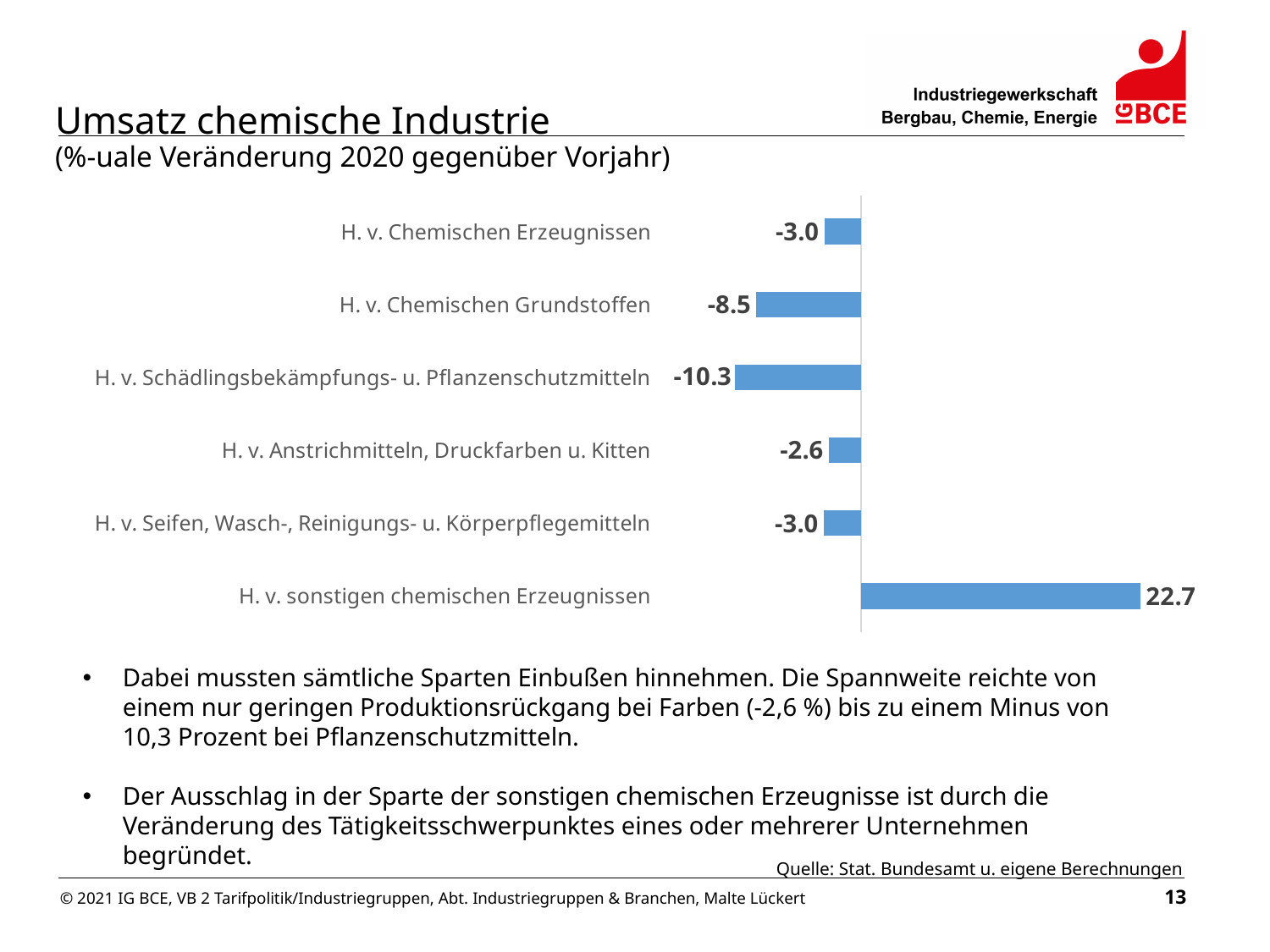
Which category has the lowest value? H. v. Schädlingsbekämpfungs- u. Pflanzenschutzmitteln What is the value for H. v. sonstigen chemischen Erzeugnissen? 22.7 What is the difference between the values for H. v. Chemischen Grundstoffen and H. v. Chemischen Erzeugnissen? 5.5 What is the title of the chart on the slide? Umsatz chemische Industrie What kind of chart is shown on the slide? Bar chart What is the value for H. v. Schädlingsbekämpfungs- u. Pflanzenschutzmitteln? -10.3 Which is larger, the value for H. v. Anstrichmitteln, Druckfarben u. Kitten or the value for H. v. Chemischen Grundstoffen? H. v. Anstrichmitteln, Druckfarben u. Kitten How many categories are shown in the chart? 6 What is the value for H. v. Chemischen Grundstoffen? -8.5 What is the value for H. v. Anstrichmitteln, Druckfarben u. Kitten? -2.6 What is the difference between the values for H. v. sonstigen chemischen Erzeugnissen and H. v. Schädlingsbekämpfungs- u. Pflanzenschutzmitteln? 33.0 Which category has the highest value? H. v. sonstigen chemischen Erzeugnissen